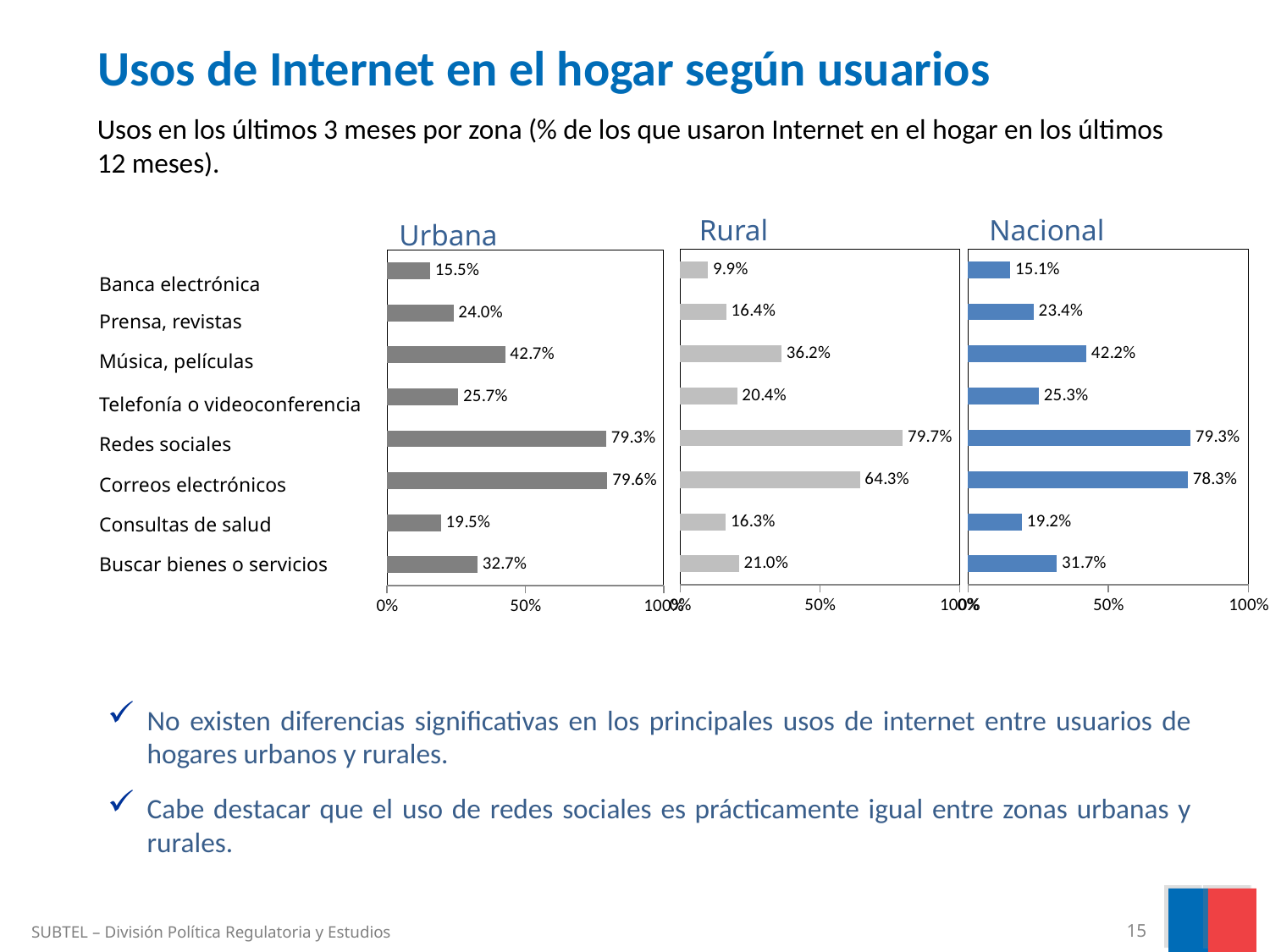
In the Rural chart, is the value for Redes sociales greater or less than 50%? greater In the Rural chart, which category has the highest value? Redes sociales In the Urbana chart, which category has the lowest value? Banca electrónica In the Rural chart, what is the value for Correos electrónicos? 64.3% In the Urbana chart, what is the value for Música, películas? 42.7% In the Nacional chart, what is the value for Buscar bienes o servicios? 31.7% How many categories are shown in the Urbana chart? 8 Which is larger: the Rural value for Música, películas or the Rural value for Telefonía o videoconferencia? Música, películas What type of chart is the Nacional chart? bar chart What is the difference between the Urbana and Rural values for Correos electrónicos? 15.3% How many charts are shown on the slide? 3 In the Nacional chart, which category has the lowest value? Banca electrónica